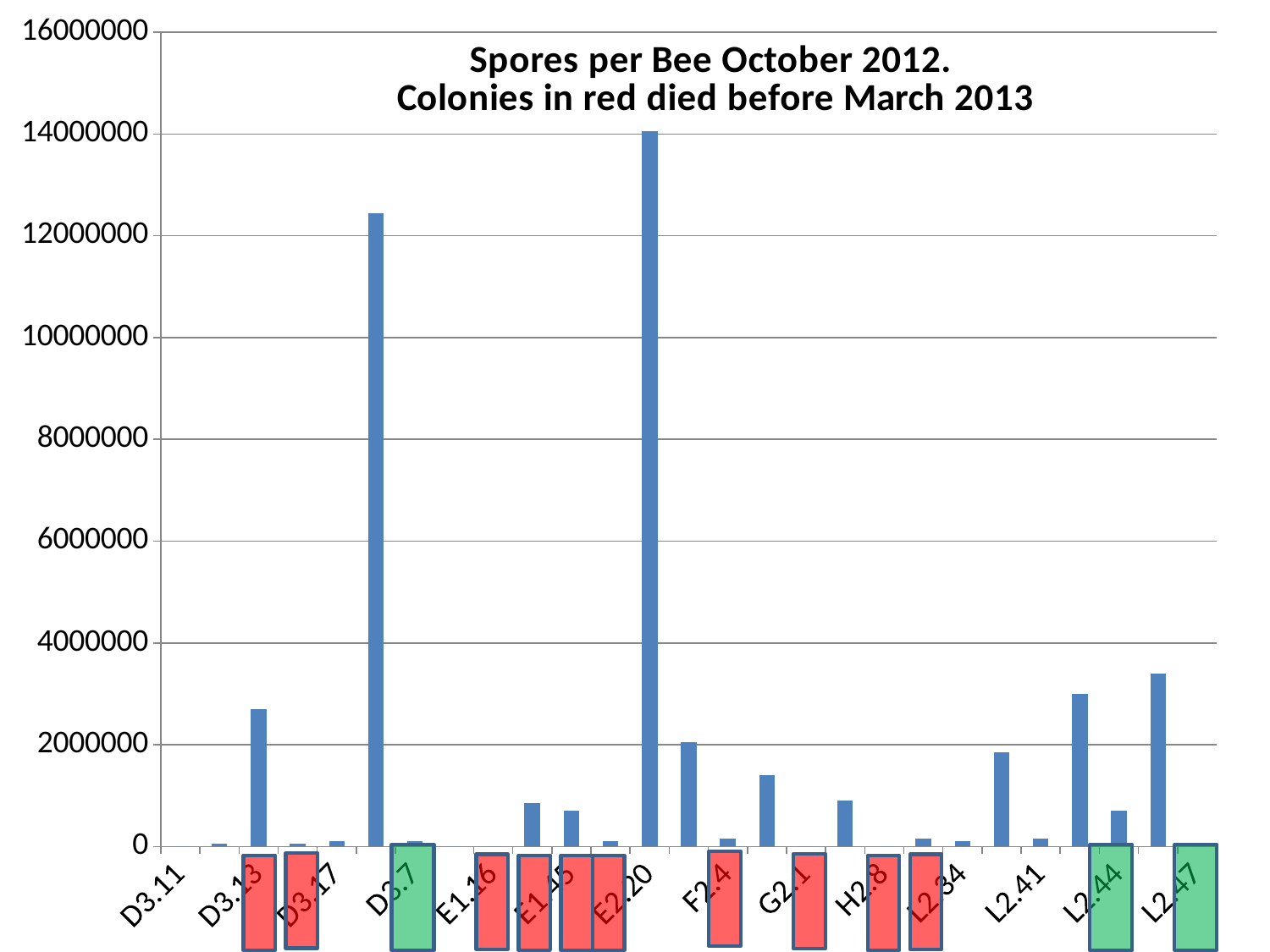
How many bars in the chart exceed 4000000 spores per bee? 2 What kind of chart is shown on the slide? bar chart Is the tallest bar in the chart greater or less than 16000000? less Is the tallest bar in the chart greater or less than 12000000? greater How many bars in the chart exceed 10000000 spores per bee? 2 What is the highest value shown on the y axis? 16000000 Which colony labels are highlighted with green boxes on the x axis? D3.7, L2.44, L2.47 What is the title of the chart? Spores per Bee October 2012. Colonies in red died before March 2013